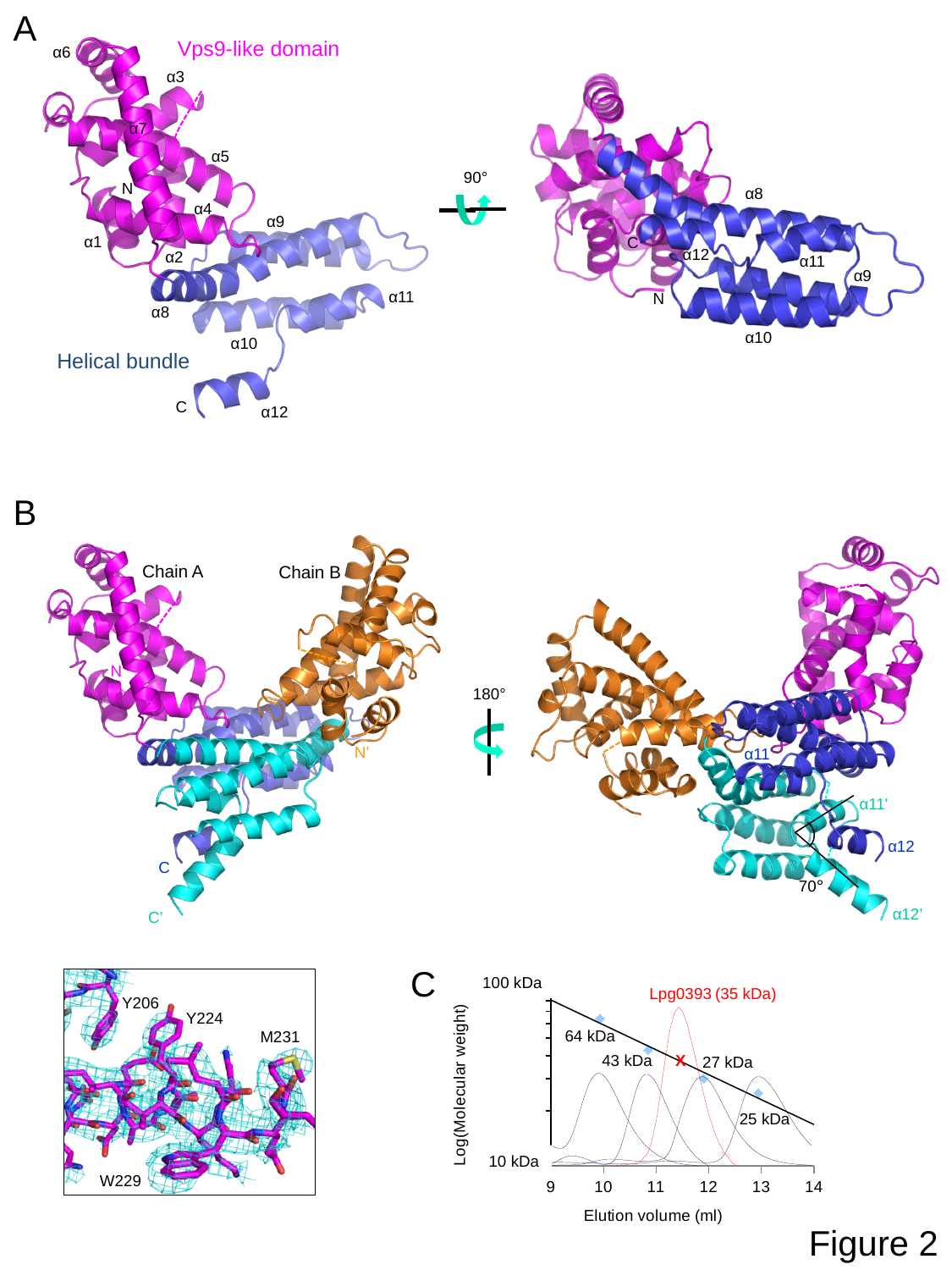
In the chart in panel C, which has the larger molecular weight, Lpg0393 or the 27 kDa standard? Lpg0393 (35 kDa) What is the x-axis label of the chart in panel C? Elution volume (ml) In the chart in panel C, is the elution volume of the 25 kDa standard peak greater or less than 12 ml? greater In the chart in panel C, what is the difference in molecular weight between the 64 kDa and 43 kDa standards? 21 kDa In the chart in panel C, how many molecular weight standards are labeled on the calibration line (excluding Lpg0393)? 4 In the chart in panel C, which labeled standard has the highest molecular weight? 64 kDa In the chart in panel C, is the elution volume of the Lpg0393 peak greater or less than 11 ml? greater In the chart in panel C, what molecular weight is given for Lpg0393? 35 kDa What is the y-axis label of the chart in panel C? Log(Molecular weight) In the chart in panel C, which labeled standard has the lowest molecular weight? 25 kDa In the chart in panel C, does the calibration line rise or fall as elution volume increases? fall In the chart in panel C, what is the highest molecular weight tick labeled on the y-axis? 100 kDa